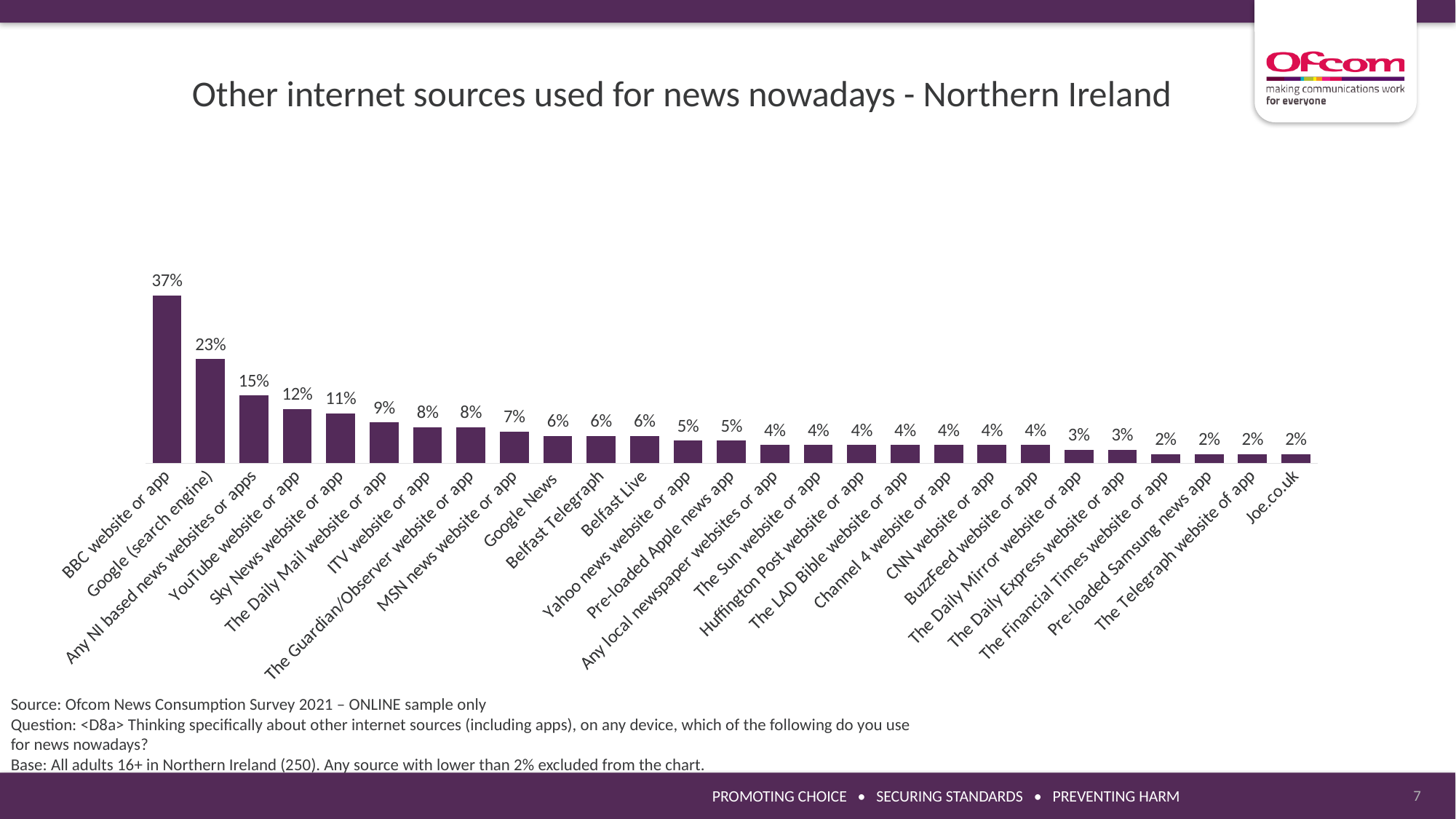
What percentage is shown for Sky News website or app? 11% What is the title of the chart? Other internet sources used for news nowadays - Northern Ireland What is the difference between the BBC website or app and Google (search engine)? 14% What percentage of respondents use the BBC website or app for news? 37% Which source has the highest value on the chart? BBC website or app What kind of chart is shown on the slide? Bar chart Which is larger, the value for Any NI based news websites or apps or the value for MSN news website or app? Any NI based news websites or apps How many sources are shown on the chart? 27 What is the value shown for Google (search engine)? 23% Do the values rise or fall moving from left to right along the x axis? Fall What is the value for Belfast Telegraph? 6% What is the difference between YouTube website or app and The Daily Mail website or app? 3%